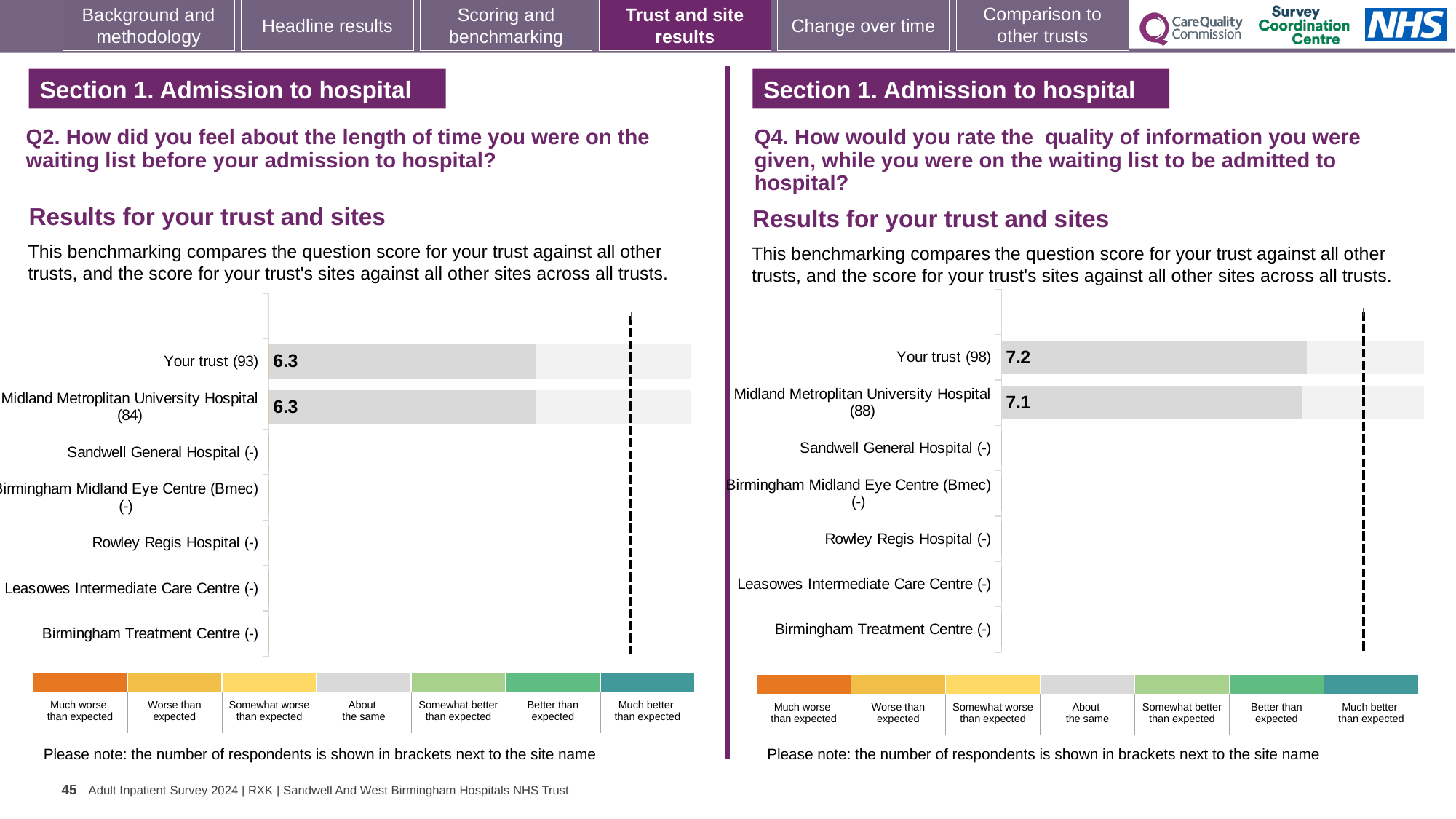
On the Q2 chart (left), what is the label of the leftmost colour band in the legend below the chart? Much worse than expected On the Q4 chart (right), what is the difference between the score for Your trust and the score for Midland Metroplitan University Hospital? 0.1 On the Q4 chart (right), what is the score for Your trust? 7.2 On the Q2 chart (left), how many site/trust categories are listed on the vertical axis? 7 On the Q4 chart (right), what is the score for Midland Metroplitan University Hospital? 7.1 On the Q2 chart (left), how many respondents are shown in brackets for Your trust? 93 What kind of chart is used on the Q4 chart (right)? Bar chart On the Q4 chart (right), how many respondents are shown in brackets for Midland Metroplitan University Hospital? 88 Which chart shows a higher score for Your trust, the Q2 chart (left) or the Q4 chart (right)? The Q4 chart (right) On the Q2 chart (left), what is the score for Your trust? 6.3 On the Q2 chart (left), how many categories have a plotted bar with a score? 2 On the Q2 chart (left), what is the score for Midland Metroplitan University Hospital? 6.3